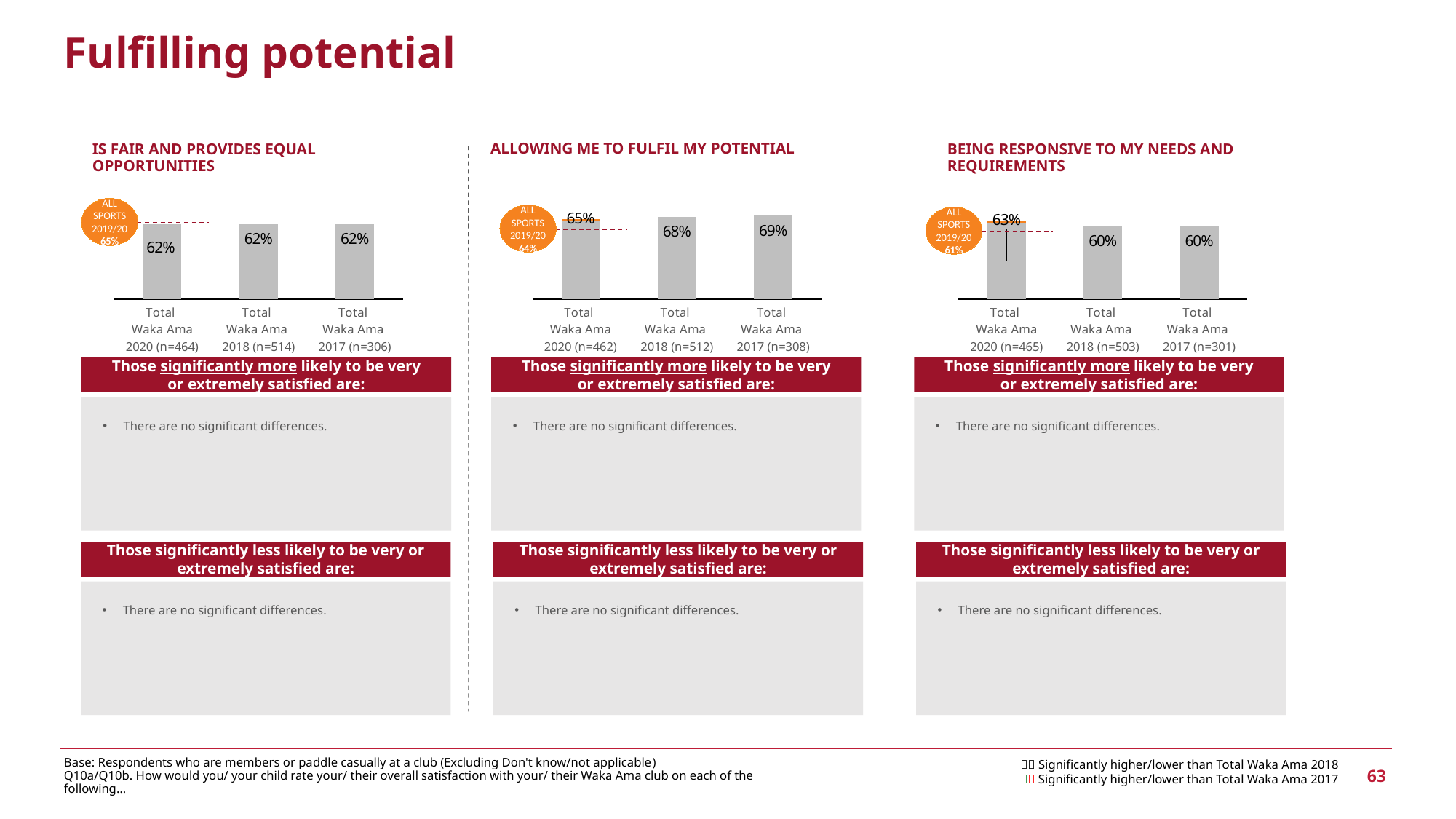
In the 'Allowing me to fulfil my potential' chart, which category has the highest value? Total Waka Ama 2017 (n=308) What kind of chart is used for 'Being responsive to my needs and requirements'? Bar chart In the 'Being responsive to my needs and requirements' chart, what is the value for Total Waka Ama 2020 (n=465)? 63% How many bars are plotted in the 'Is fair and provides equal opportunities' chart? 3 In the 'Allowing me to fulfil my potential' chart, which is larger: Total Waka Ama 2018 (n=512) or Total Waka Ama 2020 (n=462)? Total Waka Ama 2018 (n=512) In the 'Allowing me to fulfil my potential' chart, which category has the lowest value? Total Waka Ama 2020 (n=462) In the 'Allowing me to fulfil my potential' chart, what is the difference between Total Waka Ama 2017 (n=308) and Total Waka Ama 2020 (n=462)? 4% In the 'Is fair and provides equal opportunities' chart, what is the value for Total Waka Ama 2017 (n=306)? 62% In the 'Being responsive to my needs and requirements' chart, what is the difference between Total Waka Ama 2020 (n=465) and Total Waka Ama 2018 (n=503)? 3% In the 'Allowing me to fulfil my potential' chart, what is the value for Total Waka Ama 2018 (n=512)? 68% In the 'Is fair and provides equal opportunities' chart, what is the All Sports 2019/20 benchmark value shown in the orange circle? 65% In the 'Being responsive to my needs and requirements' chart, which category has the highest value? Total Waka Ama 2020 (n=465)